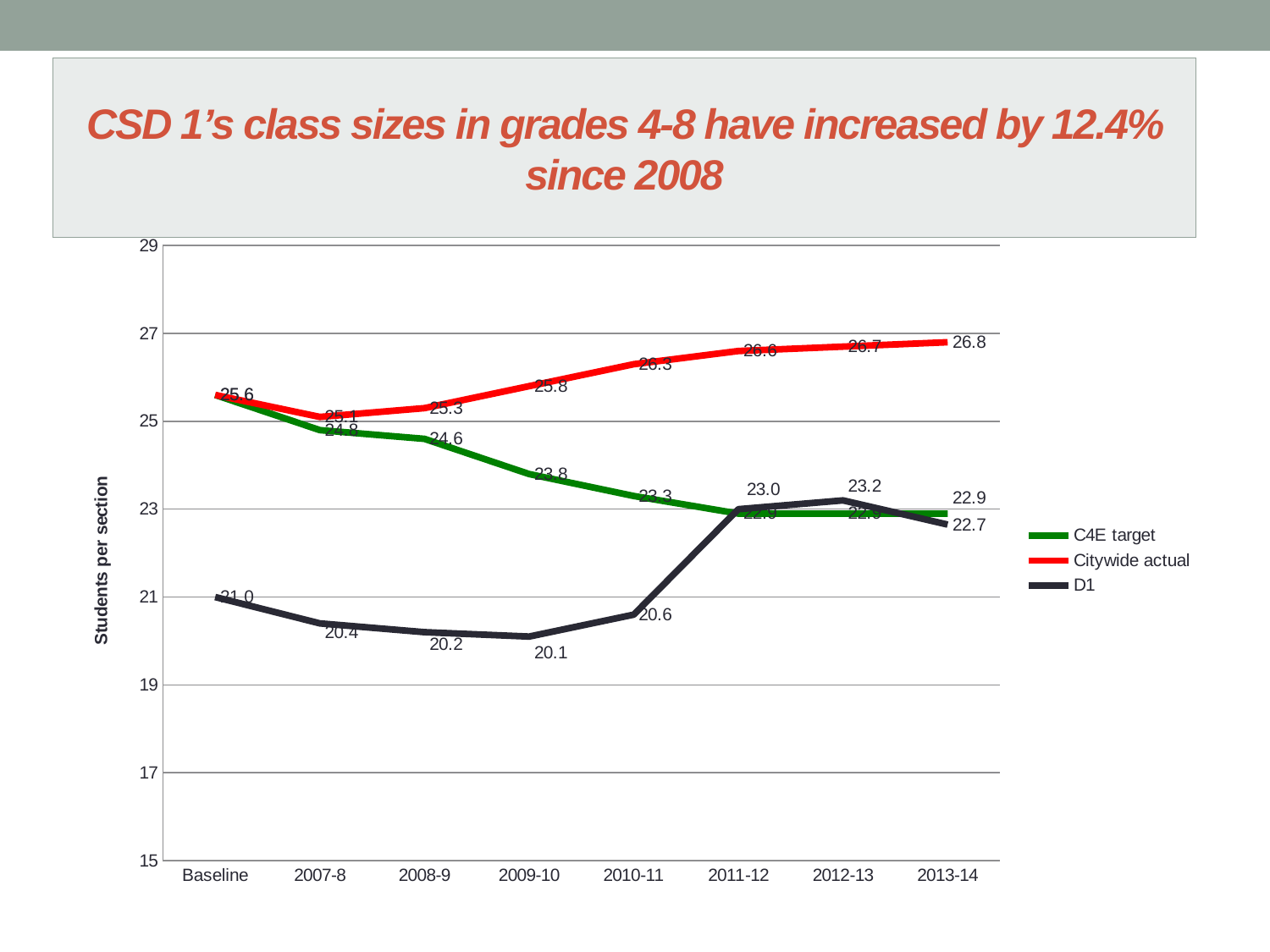
What is the Citywide actual value for 2013-14? 26.8 In 2013-14, which is larger: the C4E target or the D1 value? C4E target How many series does the legend list? 3 In which year does the D1 series reach its highest value? 2012-13 What is the difference between the D1 value in 2012-13 and in 2009-10? 3.1 In which year does the D1 series reach its lowest value? 2009-10 What is the D1 value for 2013-14? 22.7 What is the C4E target value for 2008-9? 24.6 What is the D1 value for 2009-10? 20.1 Is the Citywide actual value for 2010-11 greater or less than 27? less What kind of chart is shown on the slide? line chart How many points are on the x axis? 8